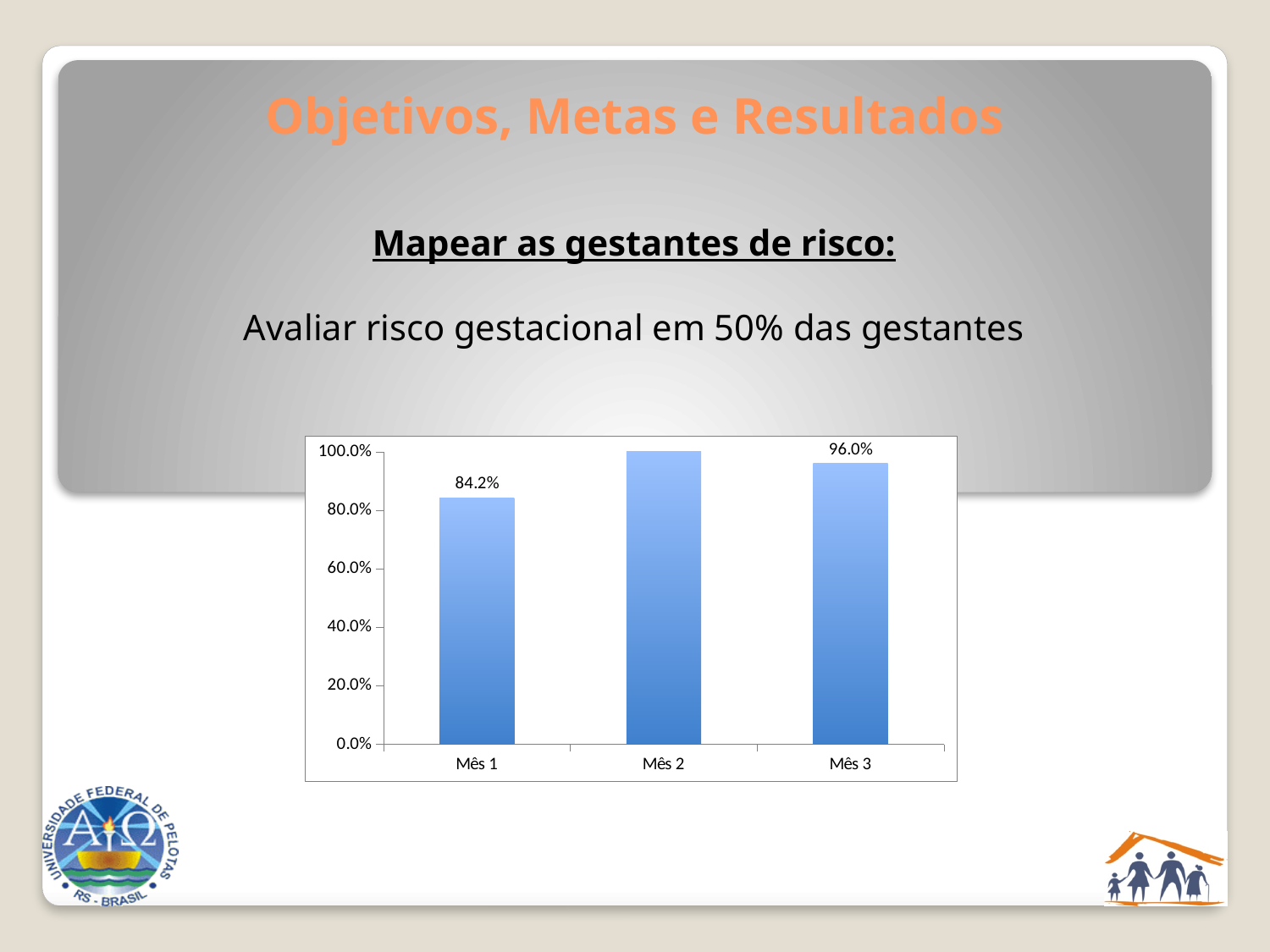
How many months are shown on the x axis of the chart? 3 Which is larger, the value for Mês 1 or the value for Mês 3? Mês 3 Does the value rise or fall from Mês 1 to Mês 2? rise Which month has the highest value? Mês 2 What is the difference between the values for Mês 3 and Mês 1? 11.8% What kind of chart is shown on the slide? bar chart Is the value for Mês 1 greater or less than 80.0%? greater Is the value for Mês 2 greater or less than 80.0%? greater What is the value for Mês 3? 96.0% What is the value for Mês 1? 84.2% Which month has the lowest value? Mês 1 What is the target percentage stated in the text above the chart? 50%